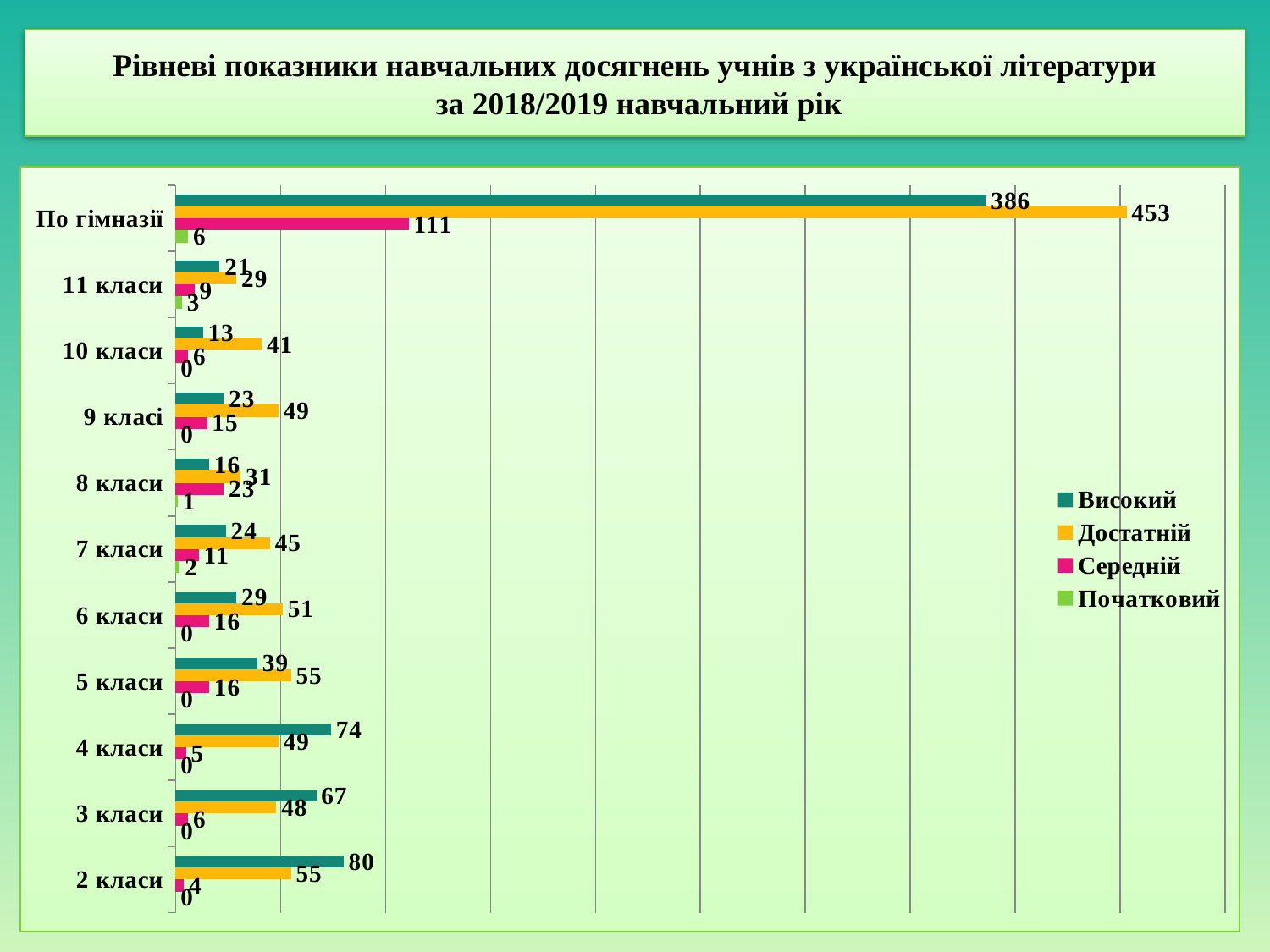
Among the class categories (excluding По гімназії), which has the highest Високий value? 2 класи What is the value of Достатній for 6 класи? 51 What is the difference between the Достатній and Високий values for По гімназії? 67 How many categories are shown on the y axis? 11 What is the value of Високий for По гімназії? 386 How many series does the legend list? 4 Among the class categories (excluding По гімназії), which has the lowest Високий value? 10 класи What is the value of Середній for 8 класи? 23 Which is larger for 4 класи: Високий or Достатній? Високий What type of chart is shown on the slide? Bar chart Which series is shown in orange in the legend? Достатній What is the value of Початковий for 11 класи? 3